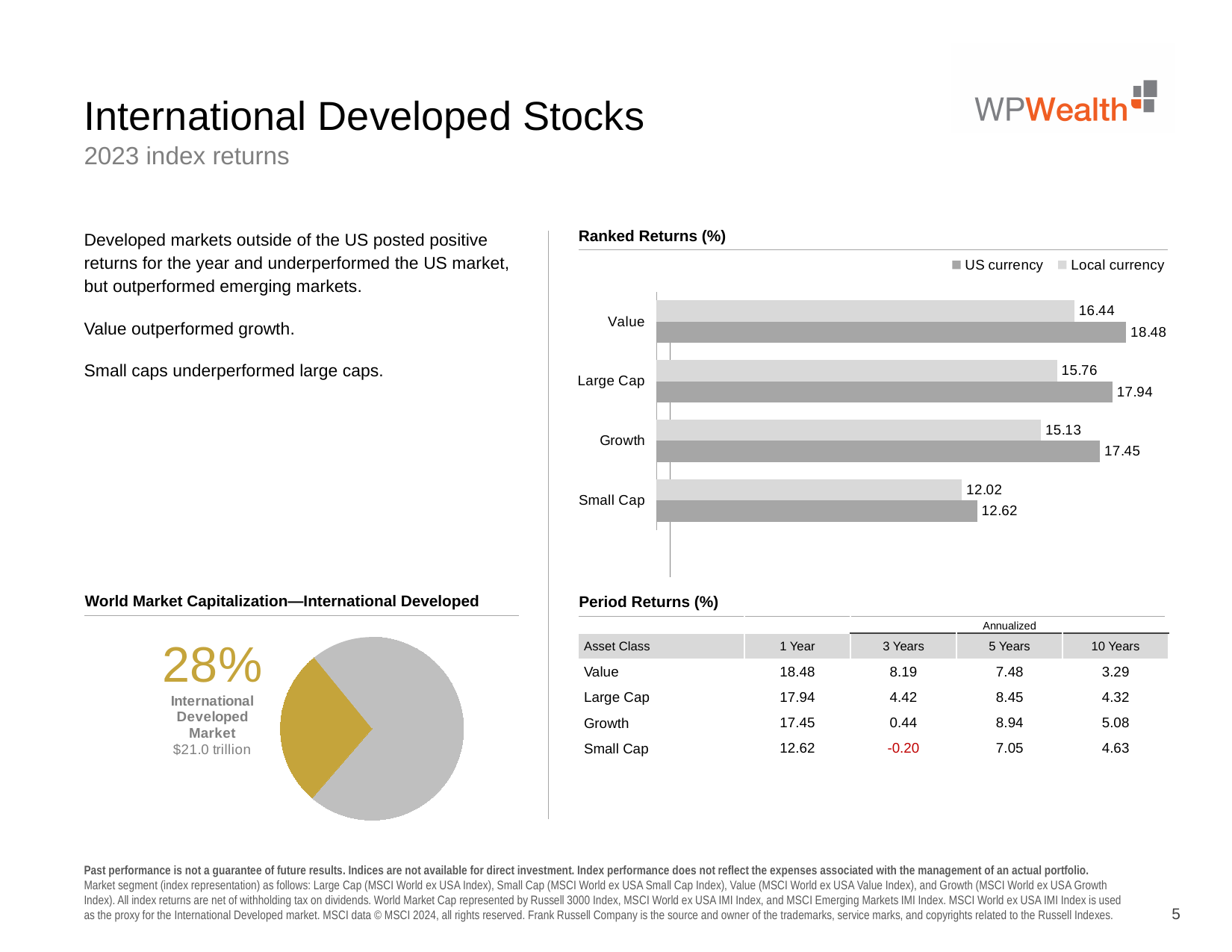
How many categories are shown in the Ranked Returns (%) chart? 4 What kind of chart is the World Market Capitalization—International Developed chart? Pie chart How many series does the legend of the Ranked Returns (%) chart list? 2 In the Ranked Returns (%) chart, what is the US currency return for Value? 18.48 In the Ranked Returns (%) chart, what is the Local currency return for Small Cap? 12.02 In the Ranked Returns (%) chart, which category has the highest US currency return? Value In the World Market Capitalization—International Developed pie chart, what share does the International Developed Market represent? 28% In the Ranked Returns (%) chart, what is the Local currency return for Growth? 15.13 In the Ranked Returns (%) chart, what is the difference between the US currency and Local currency returns for Large Cap? 2.18 In the Ranked Returns (%) chart, which category has the lowest Local currency return? Small Cap What kind of chart is the Ranked Returns (%) chart? Bar chart In the Ranked Returns (%) chart, which is larger: the US currency return for Growth or the Local currency return for Value? US currency return for Growth